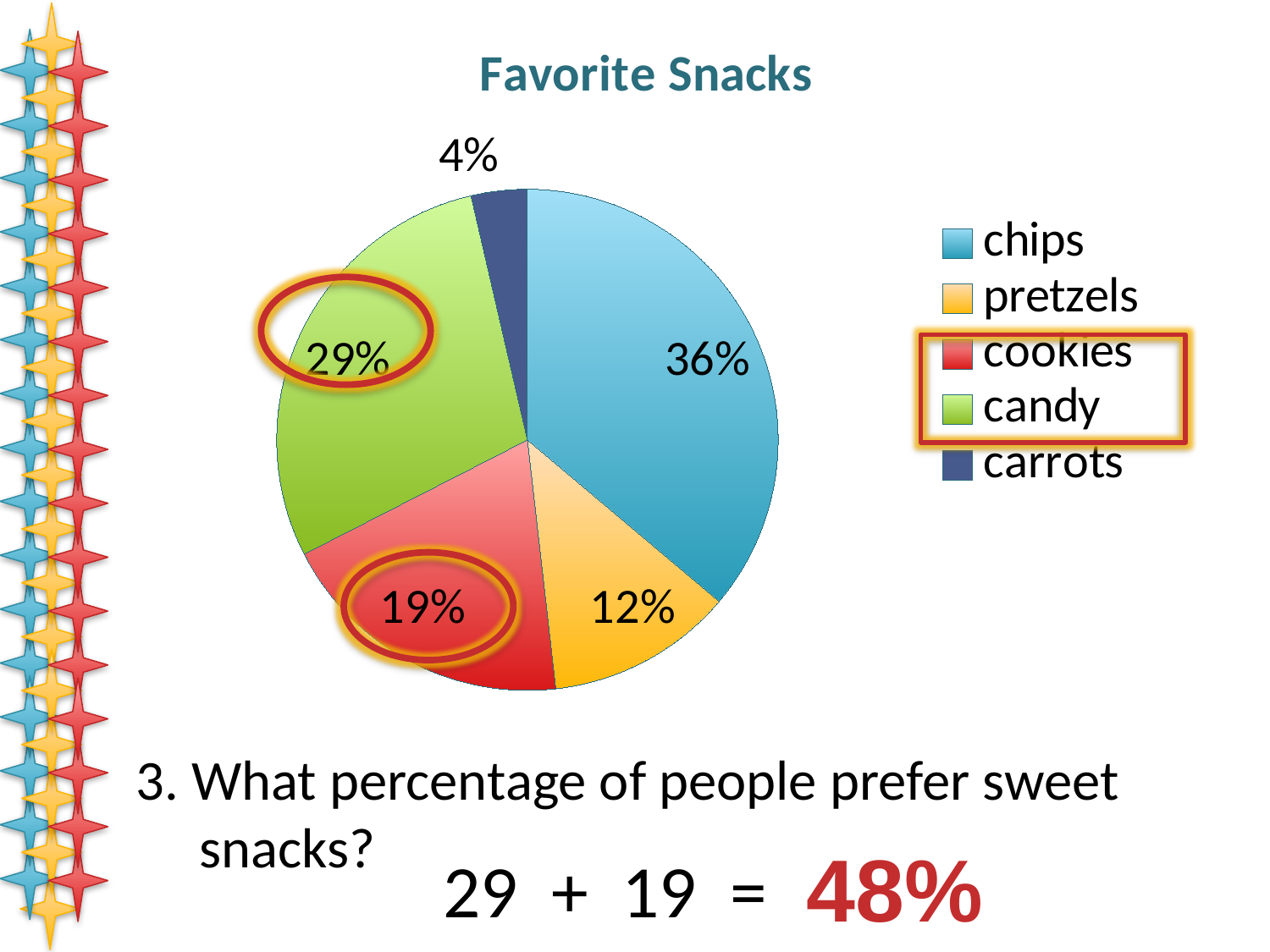
What percentage of people prefer pretzels? 12% What percentage of people prefer cookies? 19% What percentage of people prefer carrots? 4% What is the difference in percentage between chips and candy? 7% Which has a larger share, pretzels or cookies? cookies How many snack categories does the legend list? 5 What kind of chart is shown on the slide? pie chart Which snack has the largest share of the pie? chips What percentage of people prefer candy? 29% Which snack has the smallest share of the pie? carrots What is the title of the chart? Favorite Snacks What percentage of people prefer chips? 36%